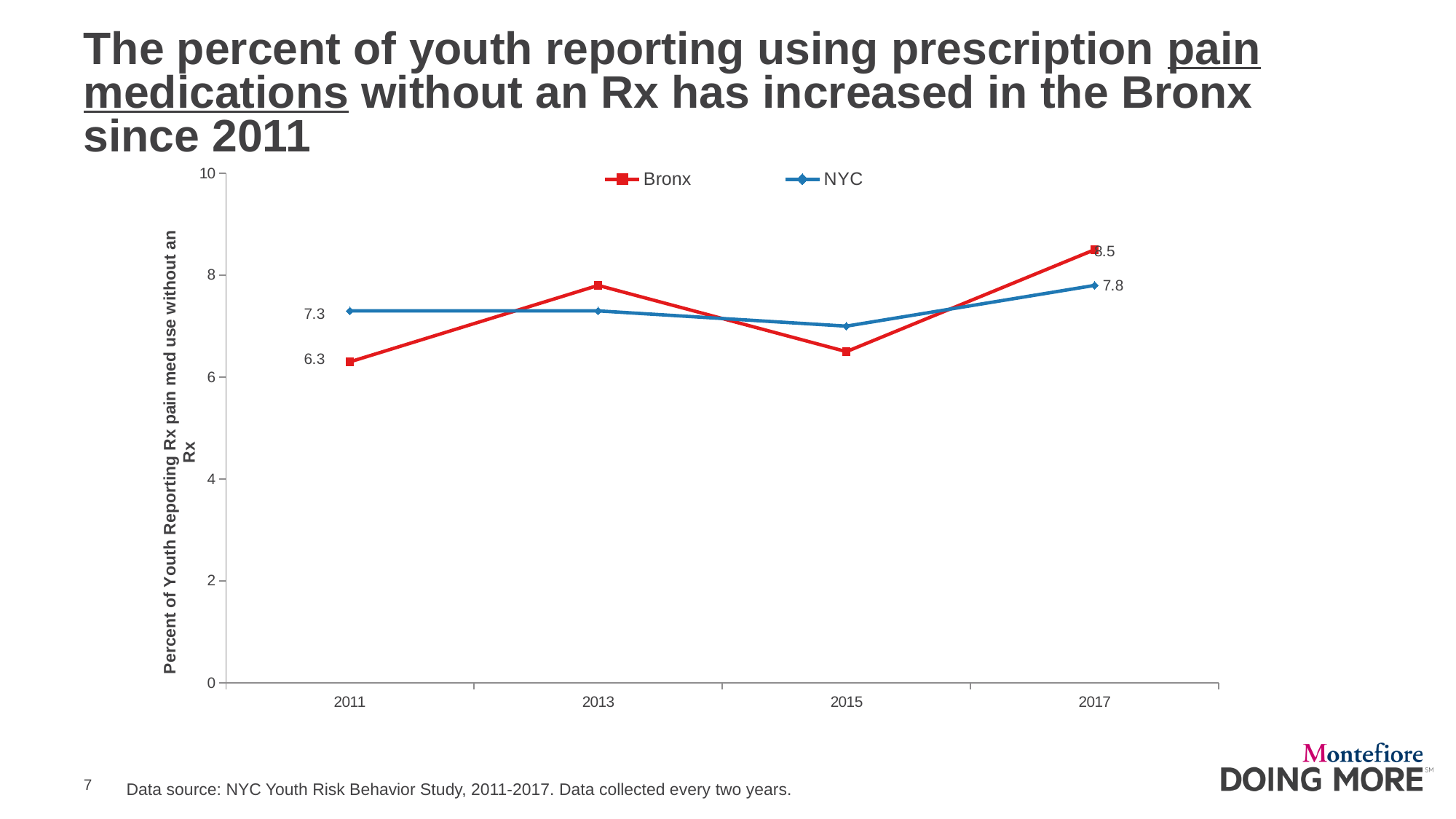
In 2011, which series has the higher value, Bronx or NYC? NYC By how much did the Bronx value increase from 2011 to 2017? 2.2 What kind of chart is shown on the slide? line chart Is the Bronx value for 2015 greater or less than 8? less What is the difference between the Bronx and NYC values in 2017? 0.7 What is the Bronx value for 2017? 8.5 How many series does the legend list? 2 How many years are plotted on the x axis? 4 What is the Bronx value for 2011? 6.3 In which year does the Bronx series reach its highest value? 2017 What is the NYC value for 2011? 7.3 What is the NYC value for 2017? 7.8